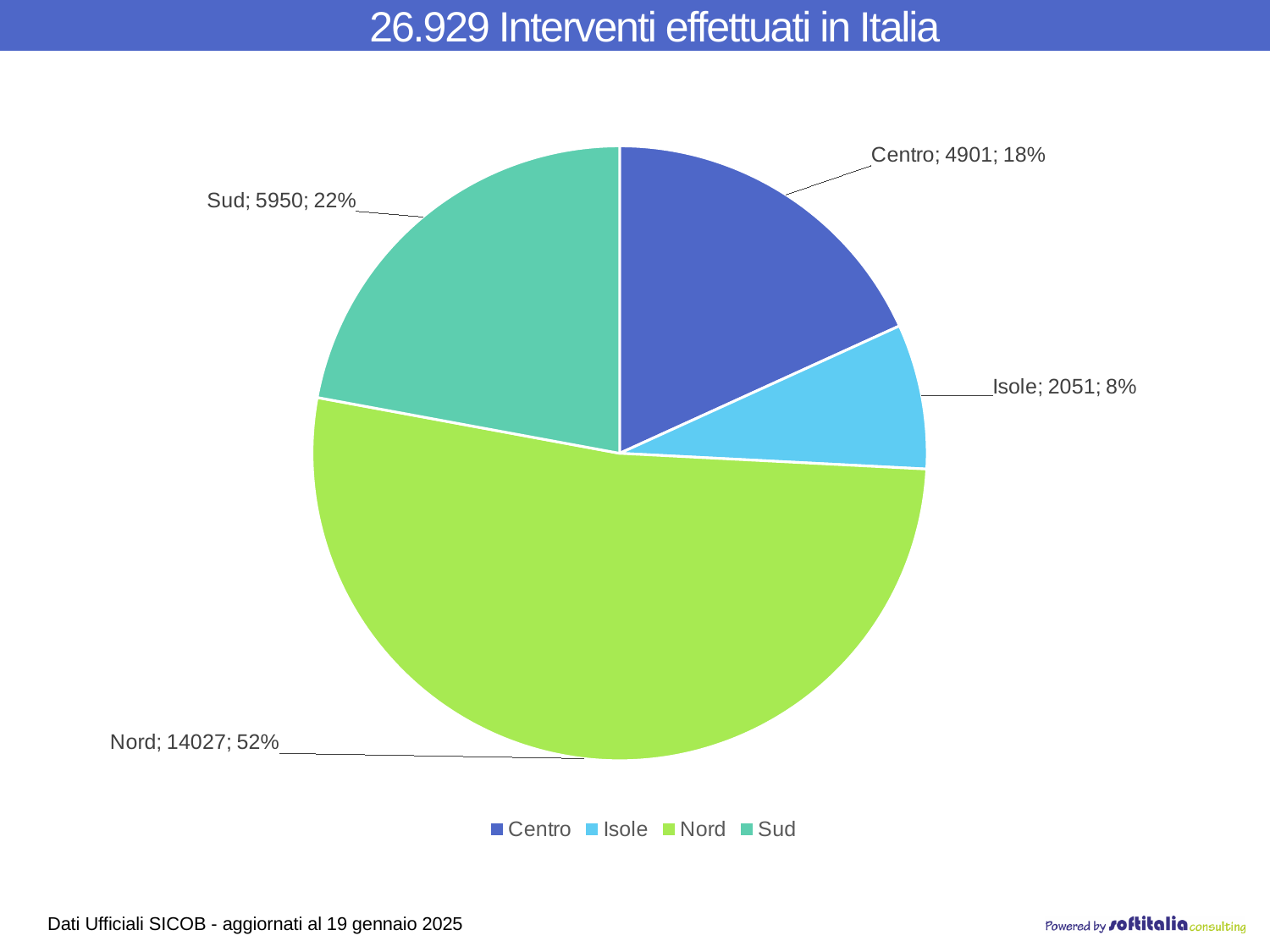
What is the title of the chart? 26.929 Interventi effettuati in Italia Which region has the smallest slice? Isole How many slices does the pie chart have? 4 What percentage share does Sud have? 22% What type of chart is shown on the slide? Pie chart How many entries does the legend list? 4 How many interventions are shown for Isole? 2051 What is the difference between the number of interventions for Sud and Centro? 1049 How many interventions are shown for Nord? 14027 What percentage share does Centro have? 18% Which has more interventions, Centro or Isole? Centro Which region has the largest slice? Nord